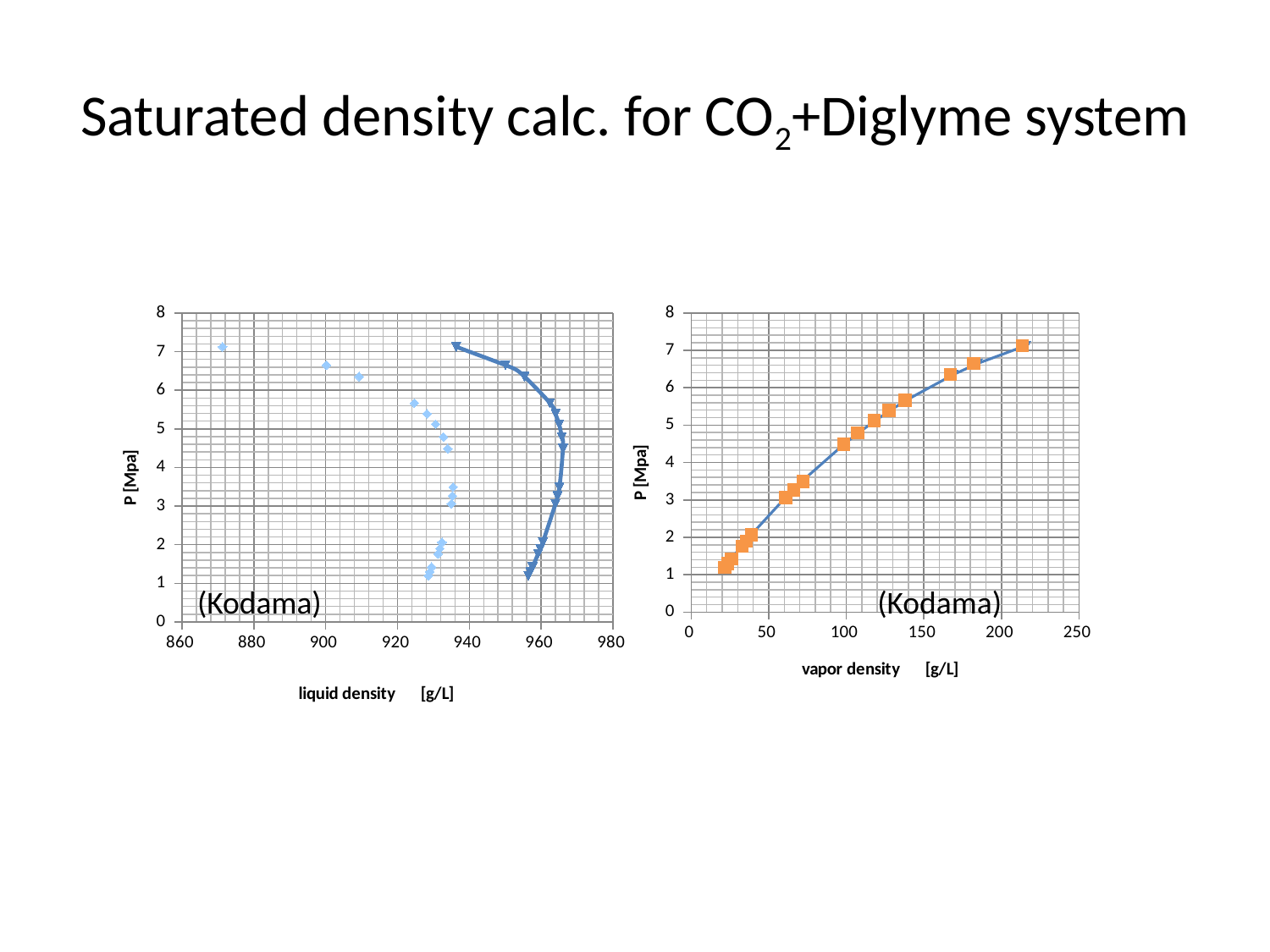
In the left chart (liquid density), is the largest liquid density reached by the dark blue line greater or less than 960 g/L? greater In the right chart (vapor density), which has the larger vapor density: the point at about 7 MPa or the point at about 1 MPa? the point at about 7 MPa What is the x-axis title of the left chart? liquid density [g/L] What is the x-axis title of the right chart? vapor density [g/L] In the right chart (vapor density), is the vapor density at the lowest plotted pressure (about 1 MPa) greater or less than 50 g/L? less What is the maximum value shown on the y axis of both charts? 8 In the left chart (liquid density), is the liquid density of the light blue point at about 7 MPa greater or less than 880 g/L? less What kind of chart is the right chart (vapor density)? scatter chart In the right chart (vapor density), does pressure rise or fall as vapor density increases along the x axis? rise What kind of chart is the left chart (liquid density)? scatter chart